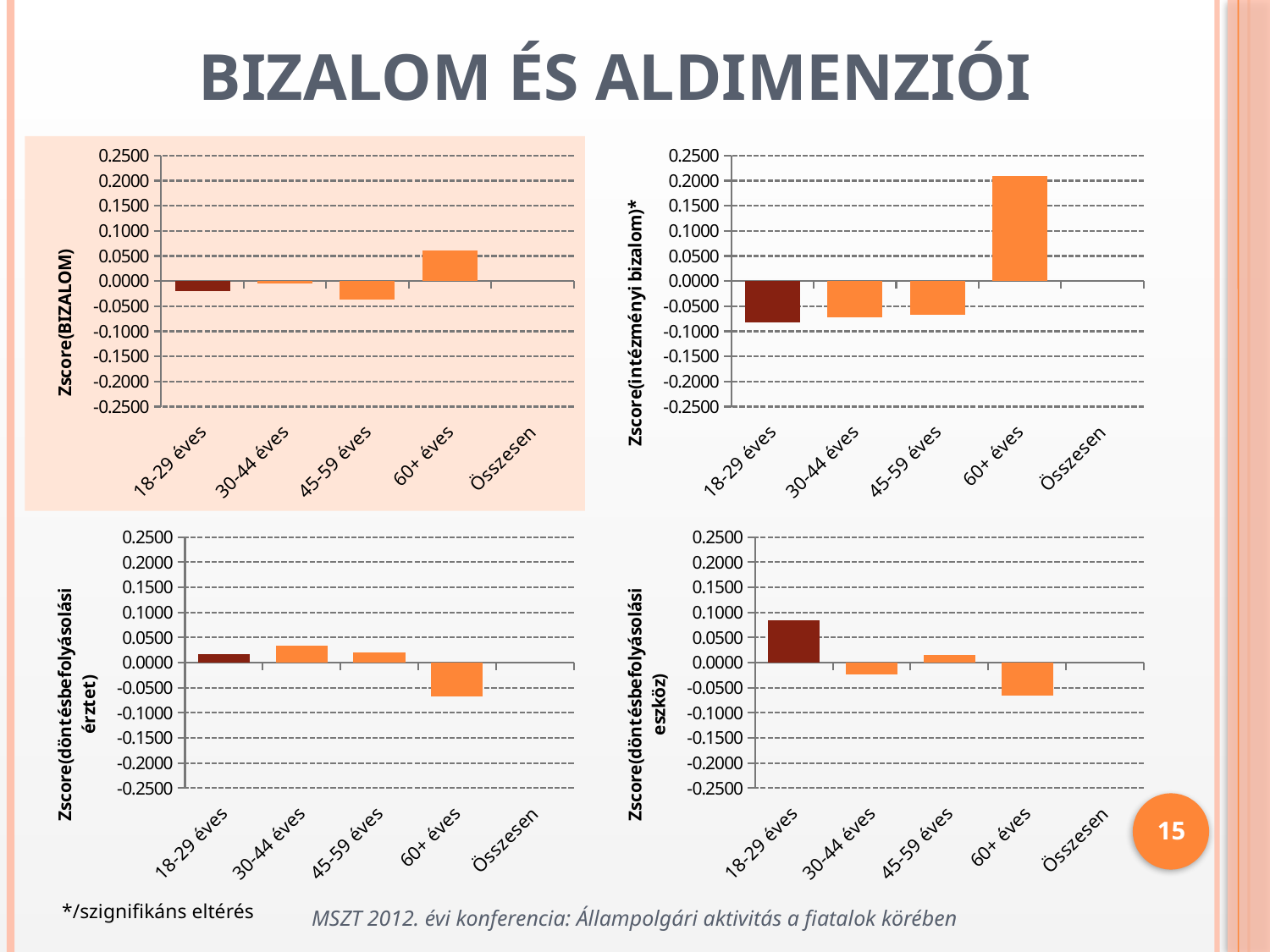
In the bottom-left chart labelled Zscore(döntésbefolyásolási érztet), is the value for 60+ éves greater or less than -0.0500? less In the bottom-right chart labelled Zscore(döntésbefolyásolási eszköz), which is larger, the value for 45-59 éves or the value for 60+ éves? 45-59 éves In the top-left chart labelled Zscore(BIZALOM), which category has the highest value? 60+ éves What kind of chart is the top-left chart labelled Zscore(BIZALOM)? bar chart In the top-right chart labelled Zscore(intézményi bizalom)*, is the value for 60+ éves greater or less than 0.1500? greater In the top-right chart labelled Zscore(intézményi bizalom)*, is the value for 18-29 éves greater or less than -0.0500? less In the top-right chart labelled Zscore(intézményi bizalom)*, which category has the highest value? 60+ éves How many categories are shown on the x axis of the top-right chart labelled Zscore(intézményi bizalom)*? 5 In the bottom-right chart labelled Zscore(döntésbefolyásolási eszköz), which category has the highest value? 18-29 éves How many charts are shown on the slide? 4 In the bottom-left chart labelled Zscore(döntésbefolyásolási érztet), which category has the lowest value? 60+ éves